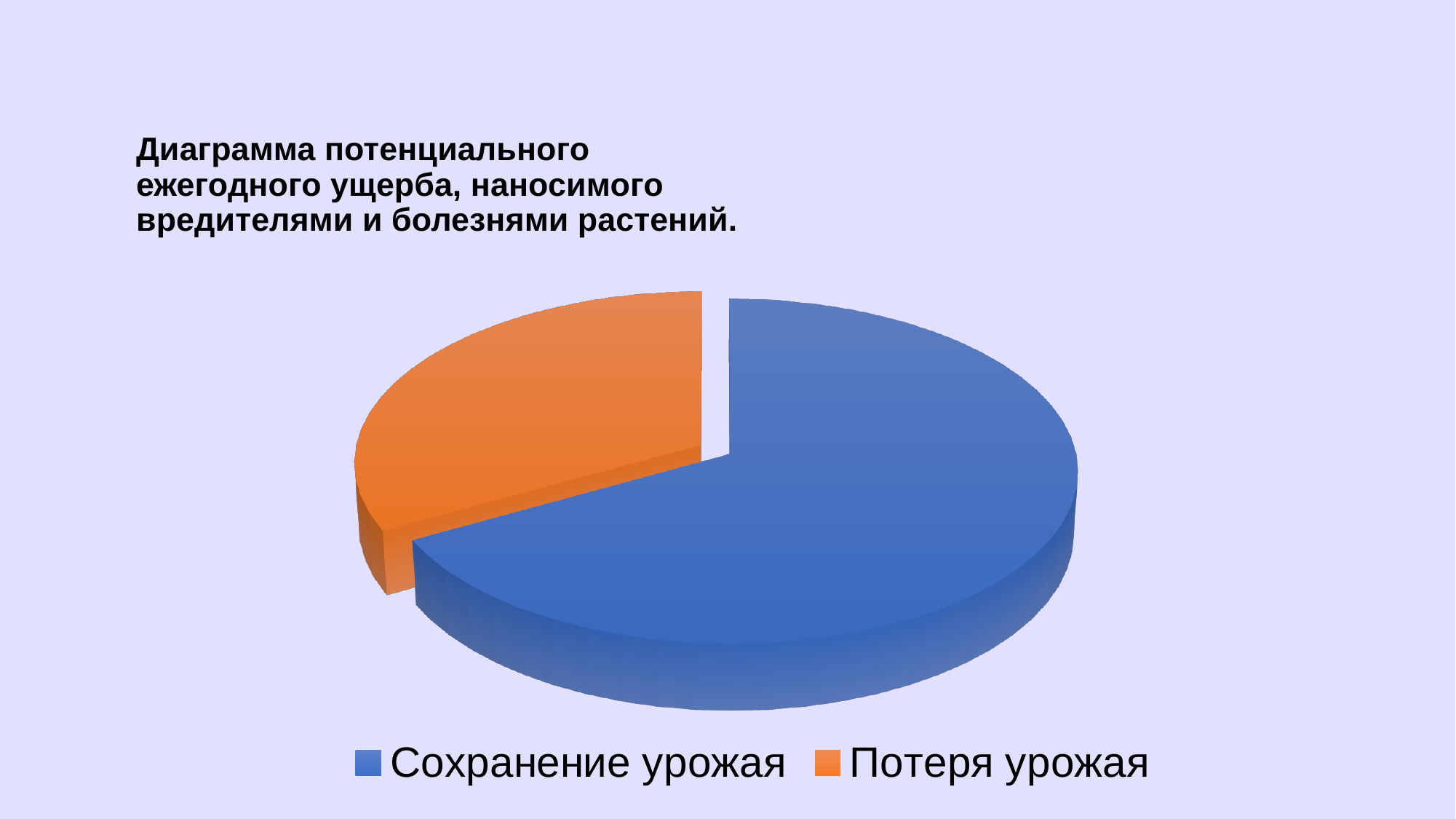
Is the slice for Потеря урожая larger or smaller than half of the pie? Smaller What colour is the slice for Потеря урожая? Orange Which category has the smallest slice of the pie? Потеря урожая Which slice is larger: Сохранение урожая or Потеря урожая? Сохранение урожая What colour is the slice for Сохранение урожая? Blue How many slices does the pie chart have? 2 What kind of chart is shown on the slide? Pie chart Which category has the largest slice of the pie? Сохранение урожая How many entries does the legend list? 2